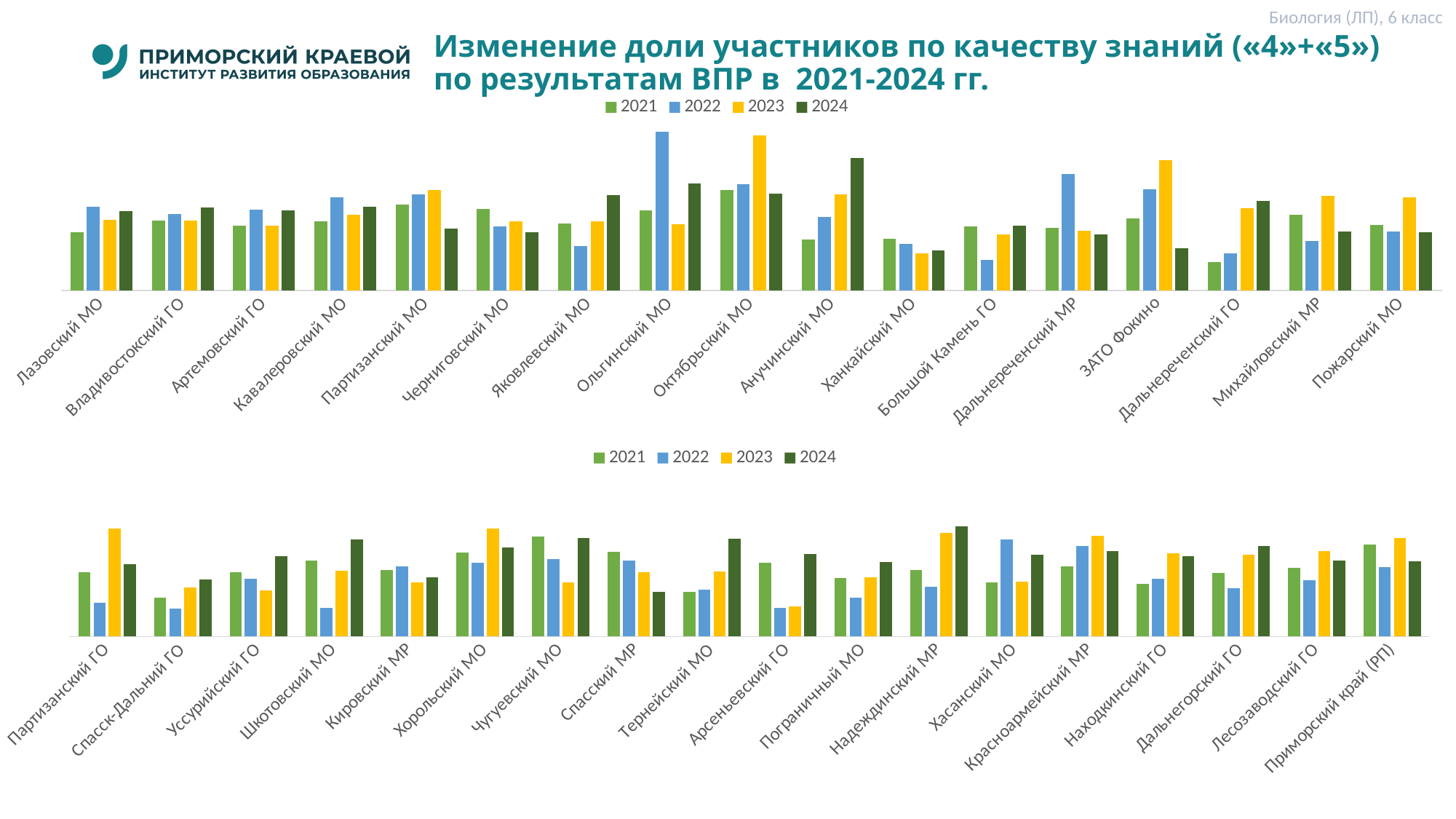
Which years are listed in the legend of the bottom chart? 2021, 2022, 2023, 2024 What kind of chart is the top chart on the slide? bar chart In the top chart, which year has the highest bar for Ольгинский МО? 2022 How many categories are shown on the x axis of the top chart? 17 In the bottom chart, which year has the lowest bar for Спасский МР? 2024 In the top chart, do the bars for Дальнереченский ГО rise or fall from 2021 to 2024? rise In the top chart, which year has the highest bar for Октябрьский МО? 2023 In the top chart, for ЗАТО Фокино, is the 2023 bar or the 2024 bar taller? 2023 In the top chart, which year has the lowest bar for Дальнереченский ГО? 2021 How many categories are shown on the x axis of the bottom chart? 18 How many series does the legend of the top chart list? 4 In the bottom chart, which year has the highest bar for Партизанский ГО? 2023